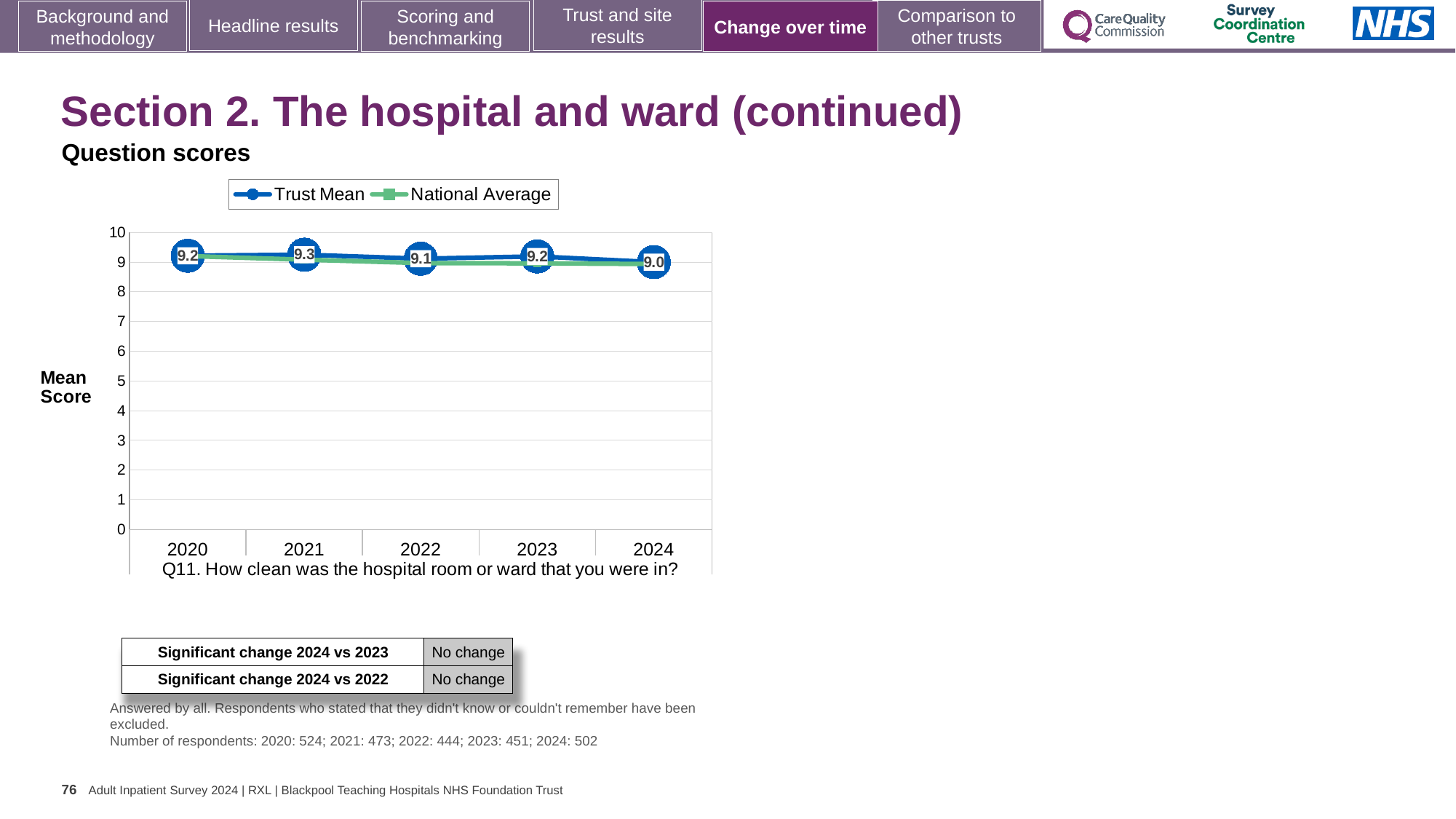
How many series does the legend list on the Q11 chart? 2 In which year is the Trust Mean lowest on the Q11 chart? 2024 What is the Trust Mean score for 2020 on the Q11 chart? 9.2 How many years are plotted on the x axis of the Q11 chart? 5 Is the National Average value for 2024 greater or less than 8? greater What is the Trust Mean score for 2024 on the Q11 chart? 9.0 In which year is the Trust Mean highest on the Q11 chart? 2021 Does the Trust Mean rise or fall from 2020 to 2024 on the Q11 chart? Fall Which year has the larger Trust Mean, 2021 or 2022? 2021 What is the Trust Mean score for 2021 on the Q11 chart? 9.3 What is the difference between the Trust Mean in 2021 and in 2024? 0.3 What kind of chart is used to show the Q11 question scores? Line chart